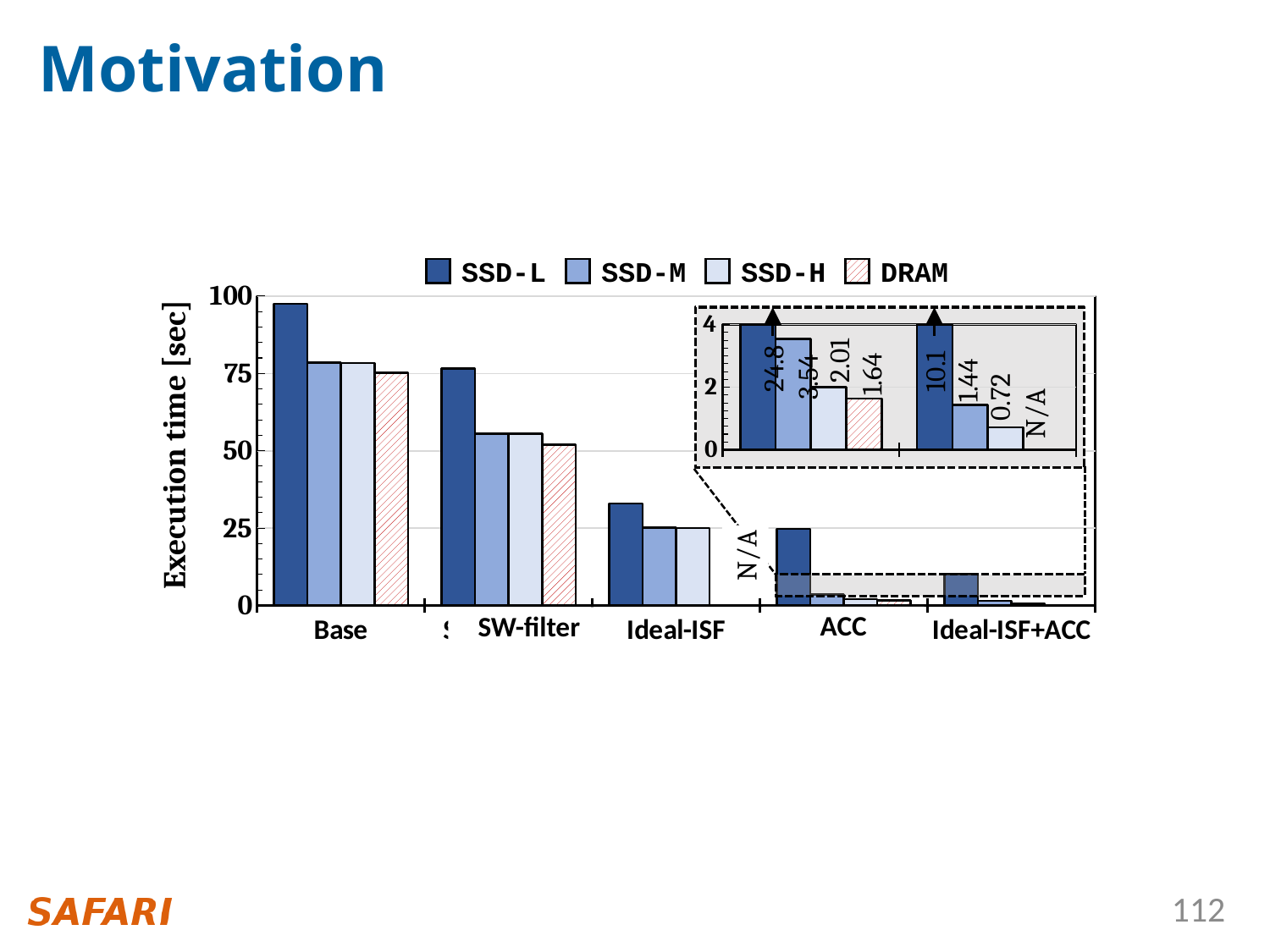
How many categories are shown on the x axis? 5 How many series does the legend list? 4 What is the execution time for SSD-L in the ACC category? 24.8 What is shown for DRAM in the Ideal-ISF+ACC category? N/A Is the SSD-M execution time for SW-filter greater or less than 75? less What is the label of the y axis? Execution time [sec] What is the execution time for DRAM in the ACC category? 1.64 Which is larger: the SSD-M value for ACC or the SSD-M value for Ideal-ISF+ACC? ACC What is the execution time for SSD-M in the ACC category? 3.54 Is the SSD-L execution time for Base greater or less than 75? greater What is the execution time for SSD-H in the Ideal-ISF+ACC category? 0.72 What is the difference between the SSD-L and SSD-M execution times in the ACC category? 21.26